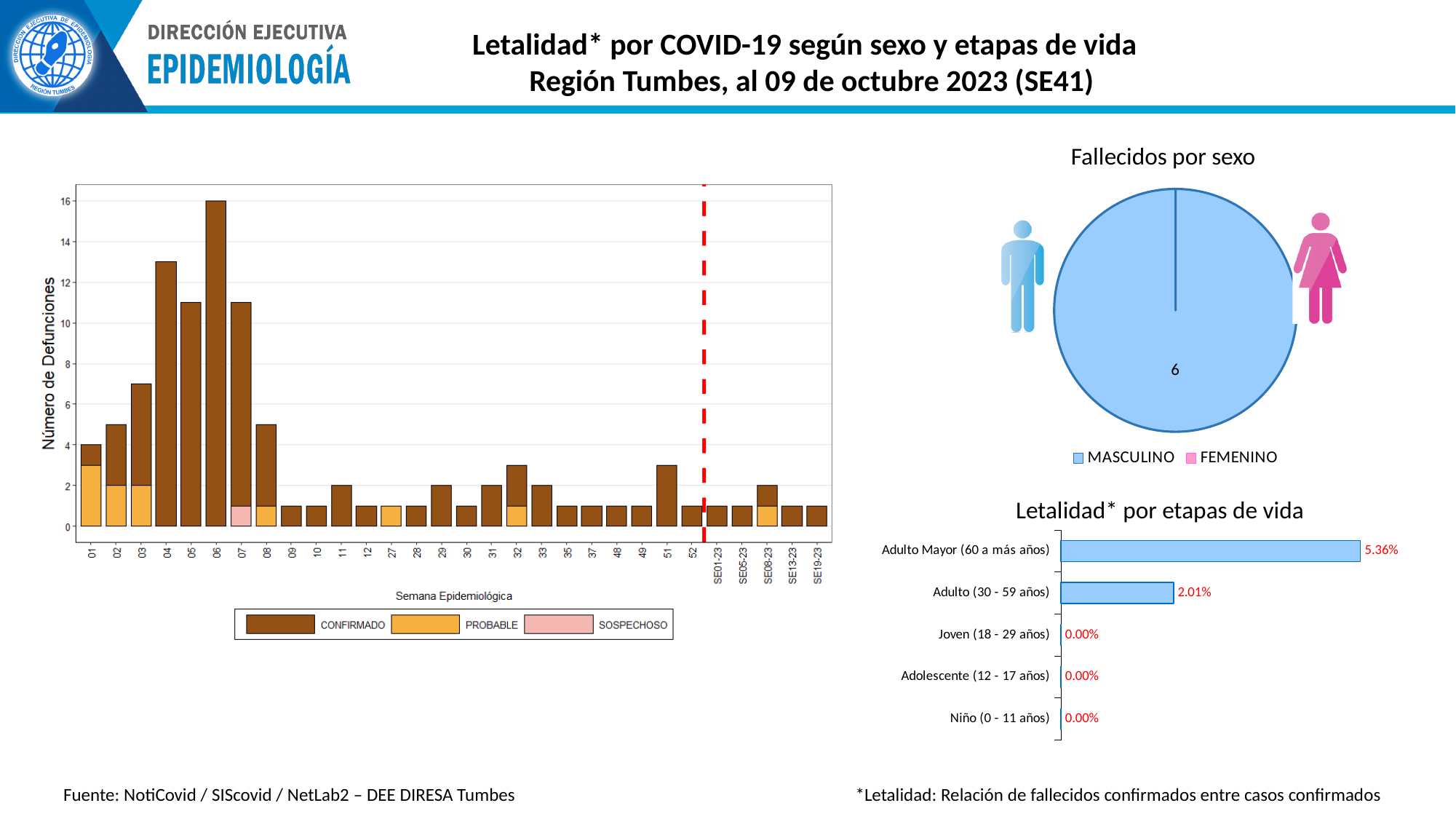
In the bar chart of deaths by epidemiological week (left), what is the total number of deaths in week 06? 16 In the 'Letalidad* por etapas de vida' chart, what is the difference between the values for Adulto Mayor (60 a más años) and Adulto (30 - 59 años)? 3.35% In the 'Letalidad* por etapas de vida' chart, what is the value for Joven (18 - 29 años)? 0.00% How many entries does the legend of the 'Fallecidos por sexo' pie chart list? 2 In the 'Letalidad* por etapas de vida' chart, which age group has the highest value? Adulto Mayor (60 a más años) In the bar chart of deaths by epidemiological week (left), which week has the highest number of deaths? 06 In the bar chart of deaths by epidemiological week (left), is the value for week 04 greater or less than 12? greater In the 'Letalidad* por etapas de vida' chart, what is the value for Adulto Mayor (60 a más años)? 5.36% How many series does the legend of the bar chart of deaths by epidemiological week (left) list? 3 In the 'Fallecidos por sexo' pie chart, what value is shown for MASCULINO? 6 In the 'Letalidad* por etapas de vida' chart, what is the value for Adulto (30 - 59 años)? 2.01% How many age groups are shown in the 'Letalidad* por etapas de vida' chart? 5